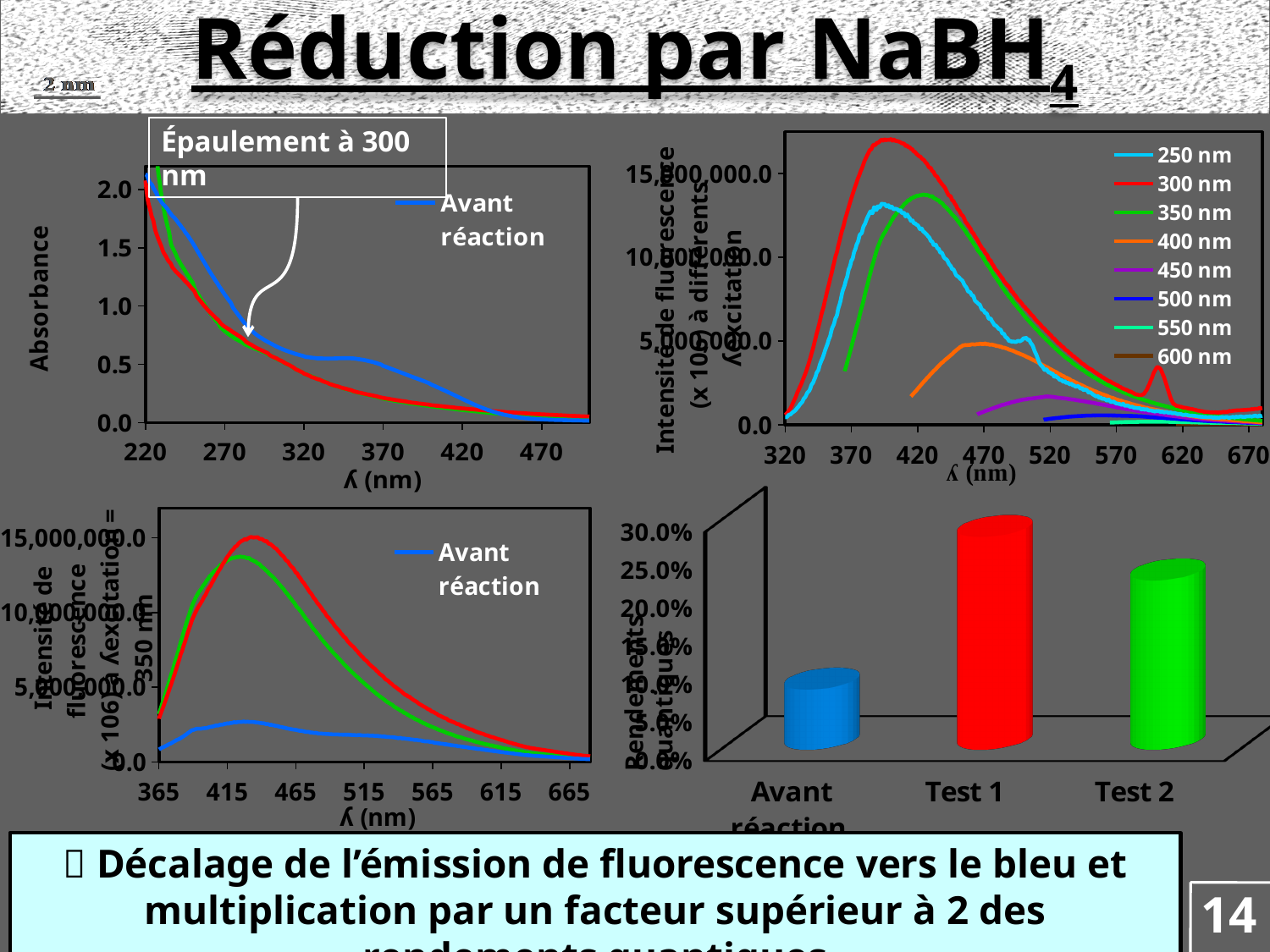
How many series does the legend of the top-right fluorescence chart list? 8 In the bottom-right bar chart, which is larger, the value for Test 2 or the value for Avant réaction? Test 2 In the top-right fluorescence chart, which excitation wavelength series reaches the highest peak intensity? 300 nm What kind of chart is the bottom-right chart with categories Avant réaction, Test 1 and Test 2? bar chart How many categories are shown in the bottom-right bar chart? 3 In the top-left Absorbance chart, do the values rise or fall as the wavelength increases from 220 nm to 470 nm? fall In the bottom-right bar chart, is the value for Test 1 greater or less than 20.0%? greater In the bottom-right bar chart, which category has the lowest value? Avant réaction In the bottom-right bar chart, is the value for Test 2 greater or less than 15.0%? greater In the bottom-right bar chart, which category has the highest value? Test 1 What kind of chart is the top-left Absorbance chart? line chart